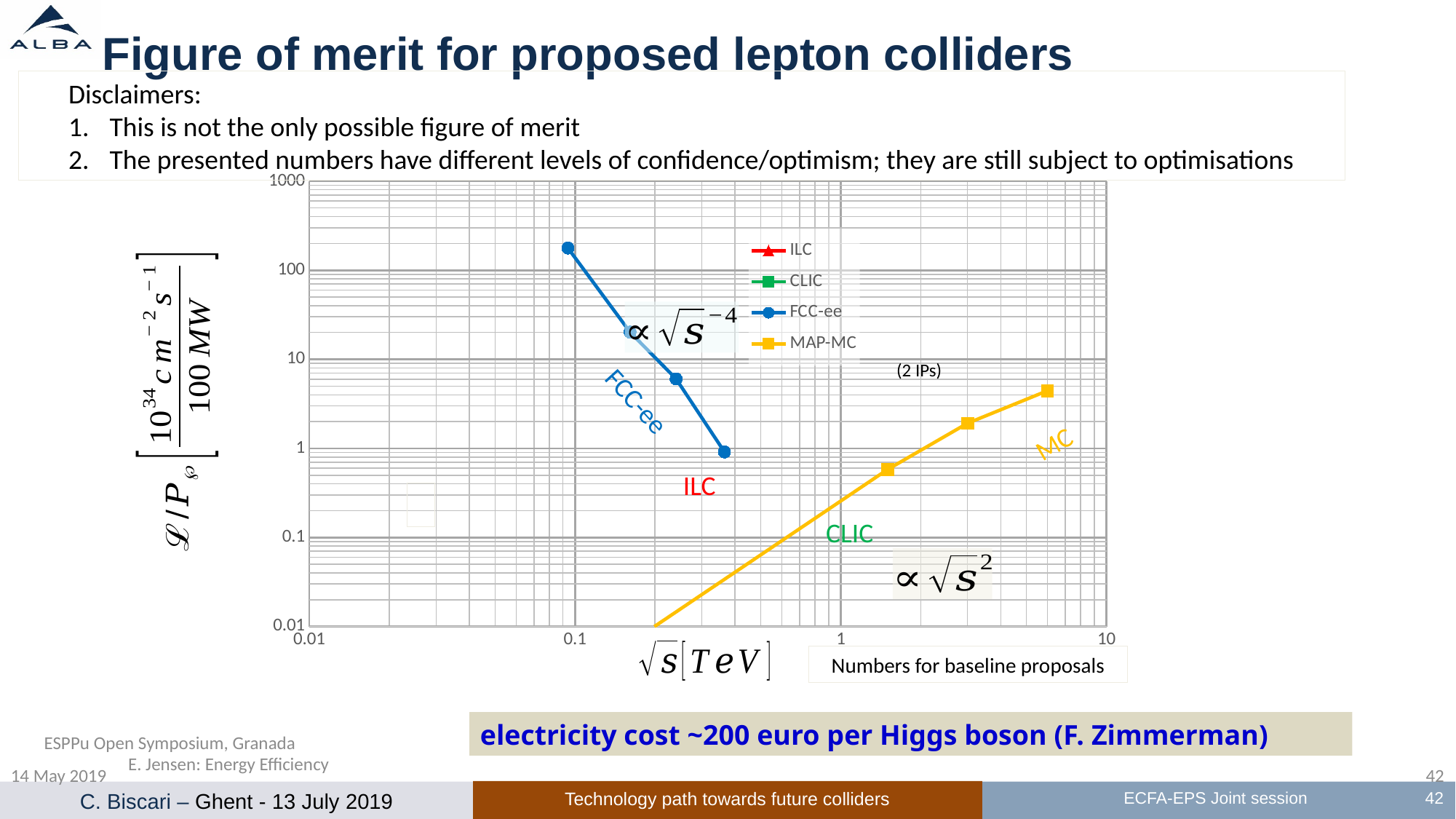
Which is larger: the highest FCC-ee value or the highest MAP-MC value? the highest FCC-ee value Is the lowest MAP-MC value greater or less than 1? less Do the FCC-ee values rise or fall as √s increases along the x axis? fall Is the highest FCC-ee value greater or less than 100? greater How many data points are plotted for the MAP-MC series? 3 Is the highest MAP-MC value greater or less than 10? less Which series reaches the highest value on the chart, FCC-ee or MAP-MC? FCC-ee How many data points are plotted for the FCC-ee series? 4 Do the MAP-MC values rise or fall as √s increases along the x axis? rise How many series does the legend list? 4 What colour is used for the MAP-MC series in the legend? yellow What kind of chart is shown on the slide? line chart